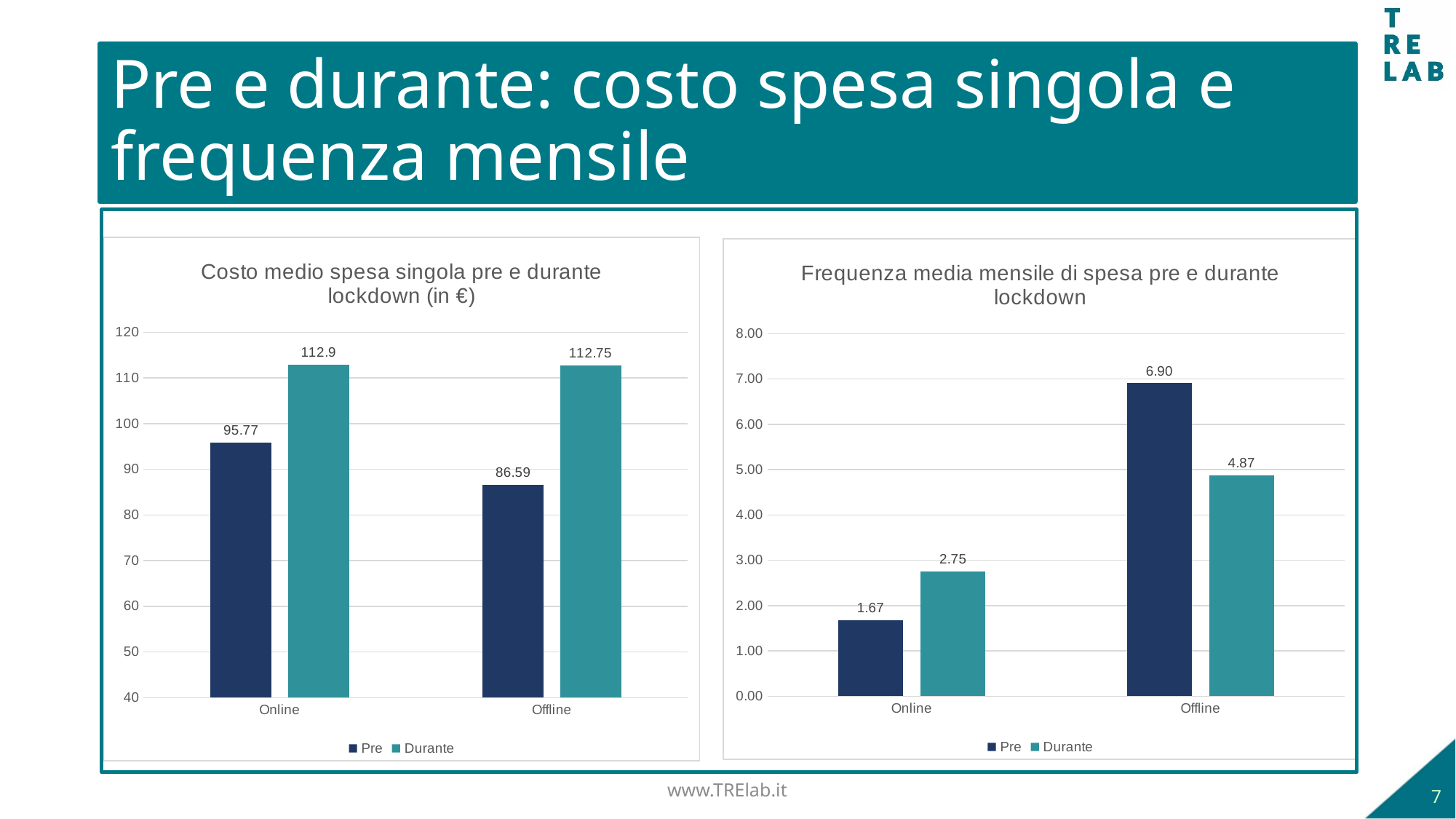
In the left chart (Costo medio spesa singola), what is the Durante value for Offline? 112.75 What type of chart is the left chart (Costo medio spesa singola)? Bar chart In the right chart (Frequenza media mensile), what is the Durante value for Online? 2.75 In the right chart (Frequenza media mensile), what is the Pre value for Offline? 6.90 In the right chart (Frequenza media mensile), is the Durante value for Offline larger or smaller than the Pre value for Offline? smaller In the right chart (Frequenza media mensile), what is the difference between the Pre and Durante values for Offline? 2.03 In the left chart (Costo medio spesa singola), is the Pre value for Online greater or less than 90? greater In the left chart (Costo medio spesa singola), what is the Pre value for Online? 95.77 In the right chart (Frequenza media mensile), which bar has the highest value? Offline Pre (6.90) In the left chart (Costo medio spesa singola), which bar has the lowest value? Offline Pre (86.59) How many series does the legend of the right chart (Frequenza media mensile) list? 2 In the left chart (Costo medio spesa singola), what is the difference between the Durante and Pre values for Online? 17.13